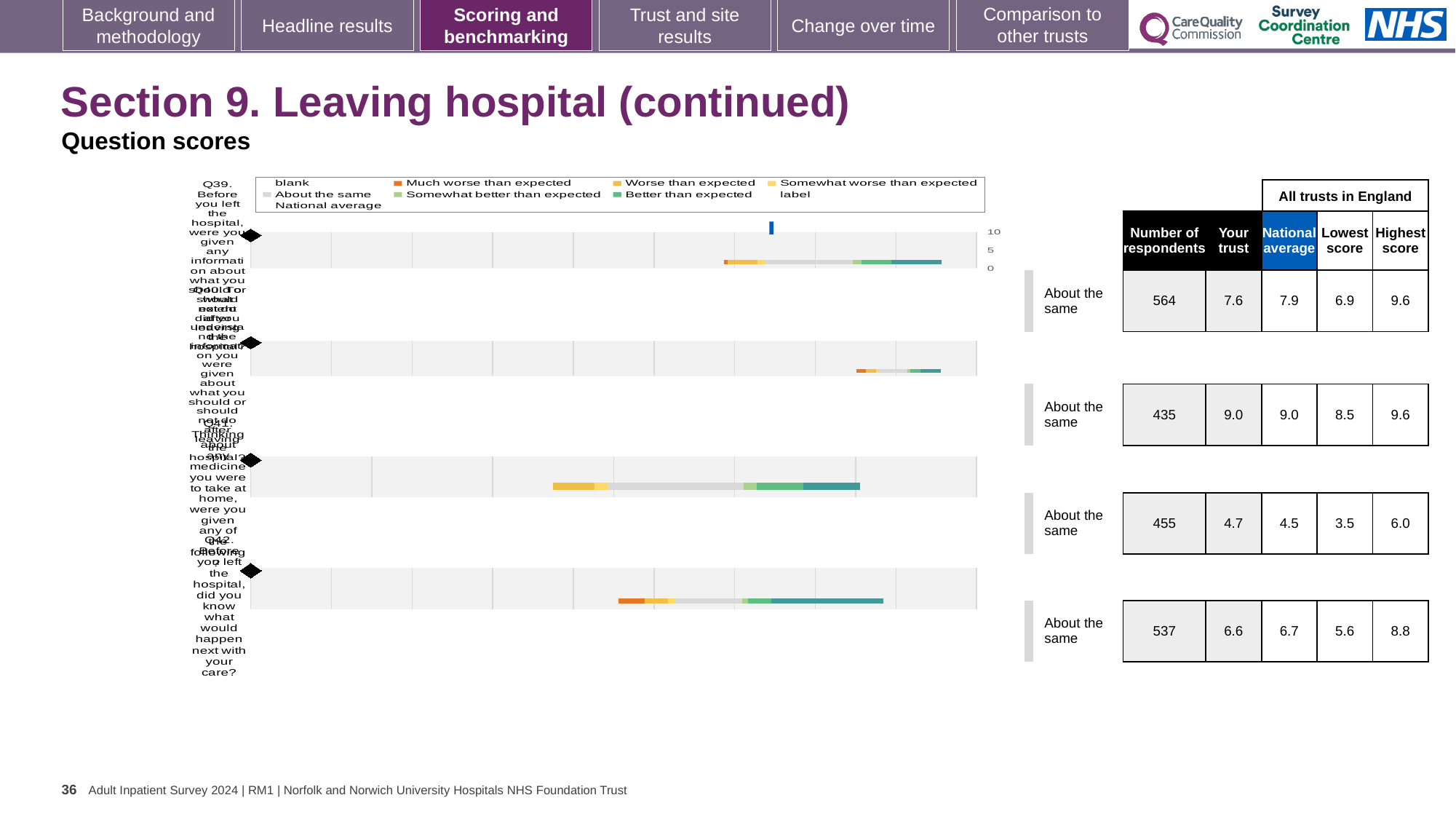
How many entries does the chart's legend list? 9 How many question rows (bars) does the chart show? 4 In the table beside the chart, what is the number of respondents for the fourth row (Q42)? 537 What is the highest value shown on the chart's axis? 10 In the table beside the chart, which row has the highest 'Your trust' score? Second row (Q40), 9.0 What benchmark category is shown next to each of the four question rows? About the same What kind of chart is shown on the slide? bar chart In the table beside the chart, what is the national average for the fourth row (Q42)? 6.7 For the first row (Q39), what is the difference between the highest score (9.6) and the lowest score (6.9)? 2.7 In the table beside the chart, which row has the lowest 'Your trust' score? Third row (Q41), 4.7 For the third row (Q41), which is larger: the 'Your trust' score or the 'National average'? Your trust (4.7) In the table beside the chart, what is the 'Your trust' score for the first row (Q39)? 7.6